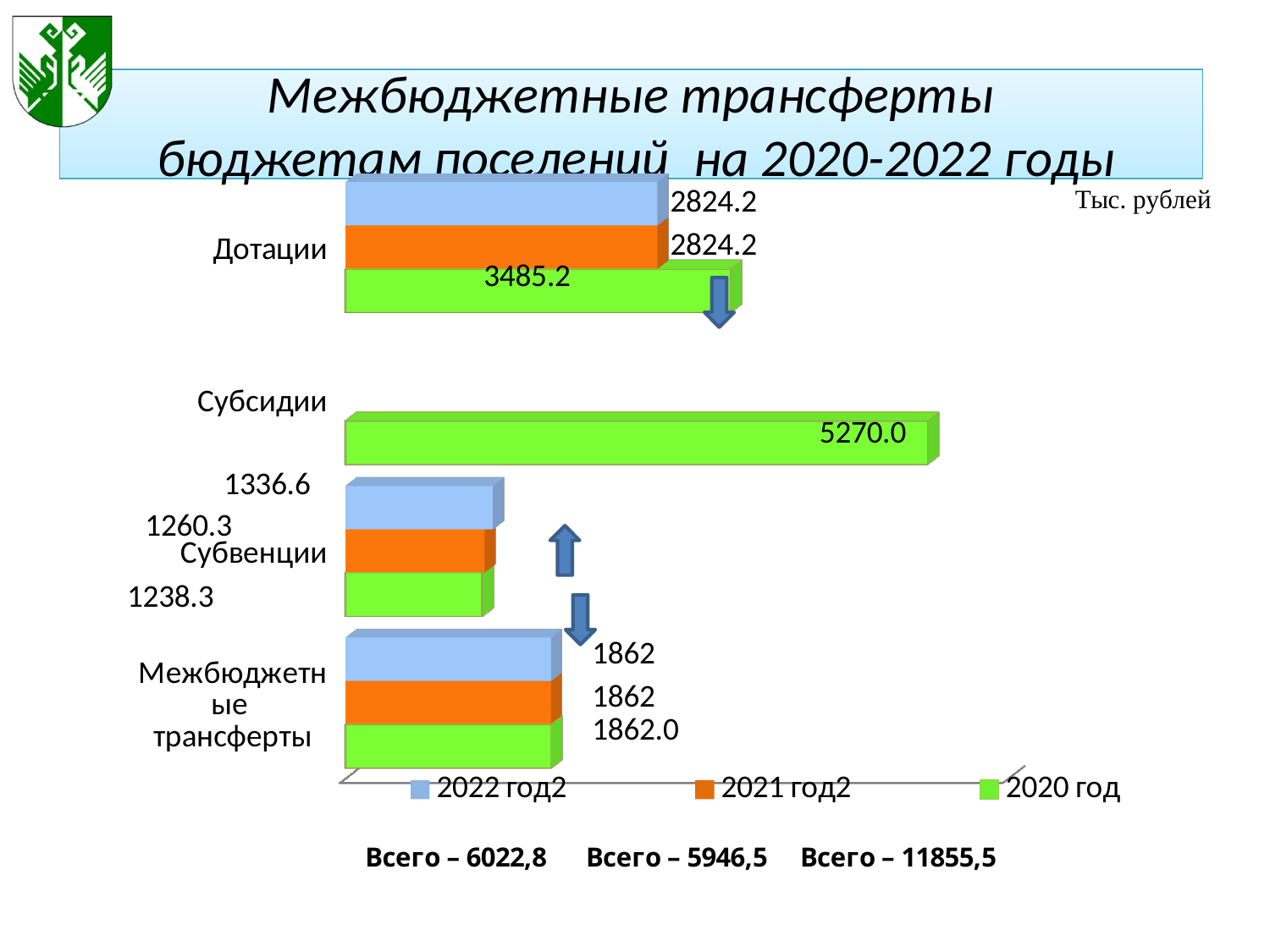
What is the value for Субвенции in the 2022 год2 series? 1336.6 Which category has the highest value in the 2020 год series? Субсидии What is the value for Субвенции in the 2021 год2 series? 1260.3 How many series does the legend list? 3 For Дотации, which series has the larger value: 2020 год or 2022 год2? 2020 год What is the value for Межбюджетные трансферты in the 2020 год series? 1862.0 What is the value for Субсидии in the 2020 год series? 5270.0 What is the difference between the 2020 год and 2022 год2 values for Дотации? 661.0 What is the difference between the 2022 год2 and 2021 год2 values for Субвенции? 76.3 What kind of chart is shown on the slide? bar chart What is the value for Дотации in the 2020 год series? 3485.2 Which category has the lowest value in the 2020 год series? Субвенции